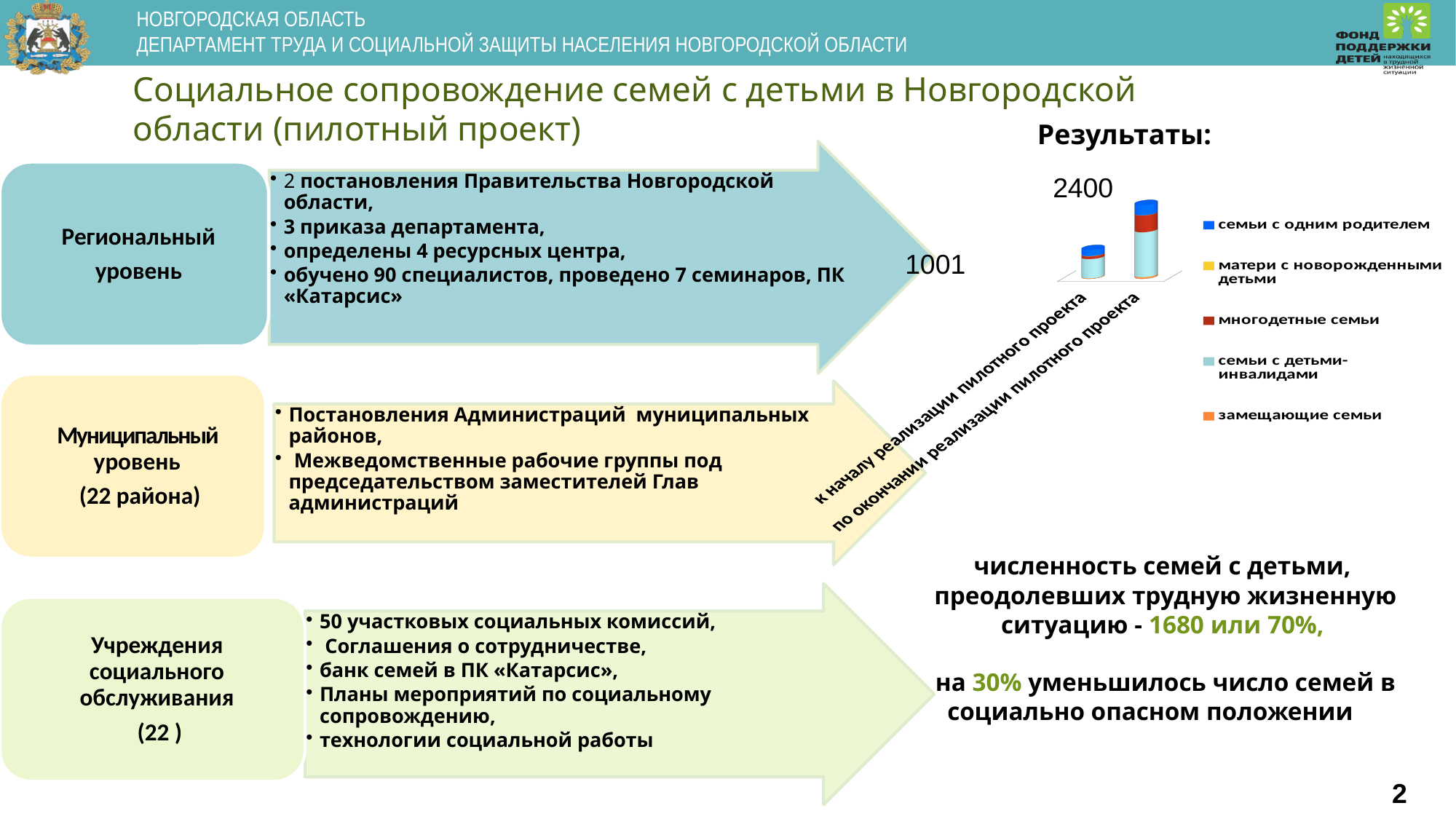
What value is labelled for the bar "к началу реализации пилотного проекта"? 1001 How many series does the chart's legend list? 5 Which is larger: the value at the start of the pilot project (к началу) or at the end (по окончании)? по окончании реализации пилотного проекта Which legend entry is shown in blue? семьи с одним родителем Which bar is the highest in the chart? по окончании реализации пилотного проекта What kind of chart is shown under "Результаты:"? bar chart How many bars (categories) does the chart show? 2 Which legend entry is shown in orange? замещающие семьи Do the bar values rise or fall from the start of the pilot project to its end? rise What is the difference between the labelled values 2400 and 1001 in the chart? 1399 Which bar is the lowest in the chart? к началу реализации пилотного проекта What value is labelled for the bar "по окончании реализации пилотного проекта"? 2400